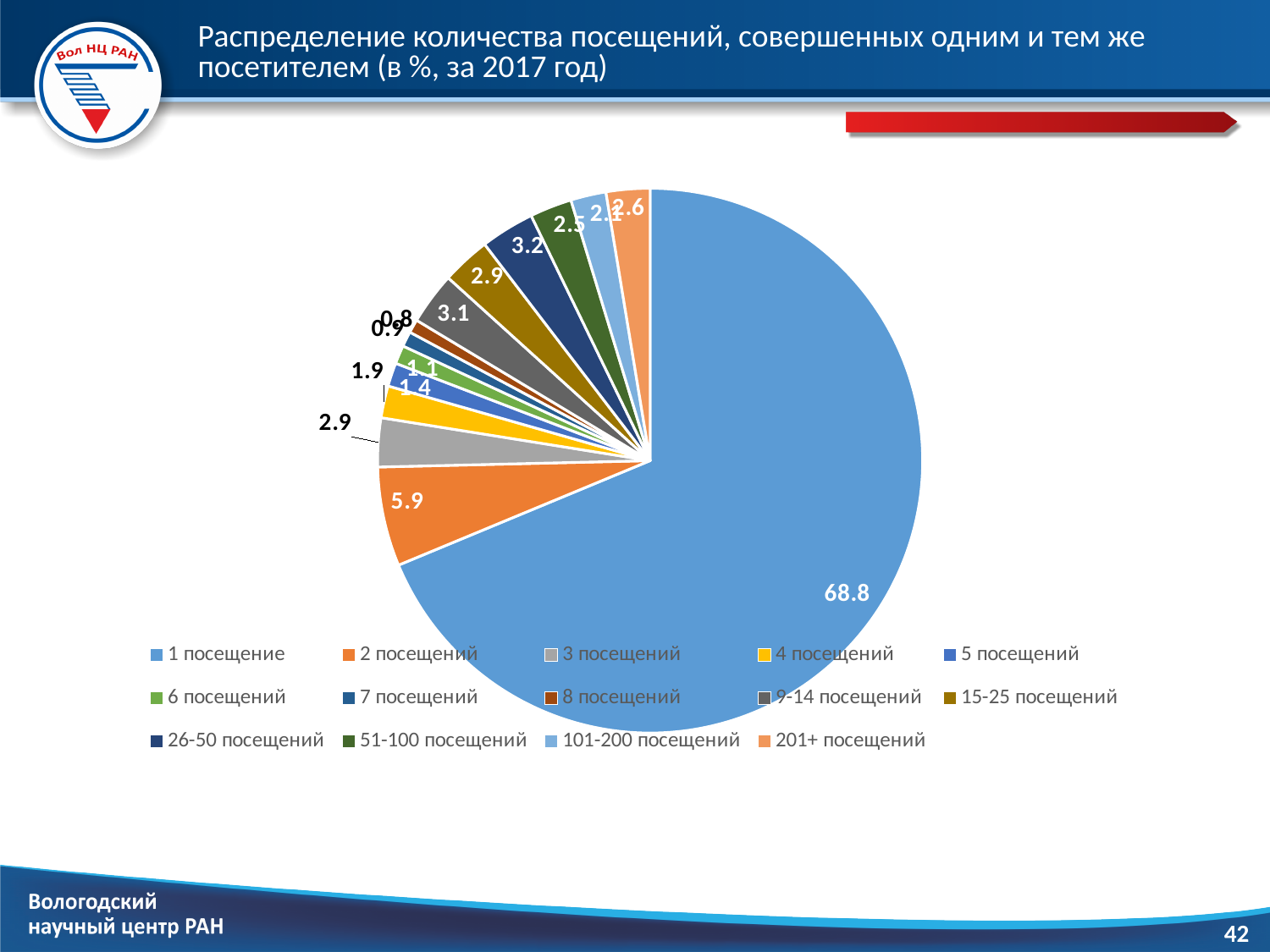
How many categories does the legend of the pie chart list? 14 What is the difference between the values for "1 посещение" and "2 посещений"? 62.9 What is the value shown for "1 посещение"? 68.8 Which category has the largest share of the pie? 1 посещение For which year does the chart title say the data is given? 2017 What is the value shown for "3 посещений"? 2.9 What is the value shown for "201+ посещений"? 2.6 What is the value shown for "26-50 посещений"? 3.2 What is the value shown for "2 посещений"? 5.9 What kind of chart is shown on the slide? pie chart Which is larger, the value for "2 посещений" or for "3 посещений"? 2 посещений What is the value shown for "4 посещений"? 1.9